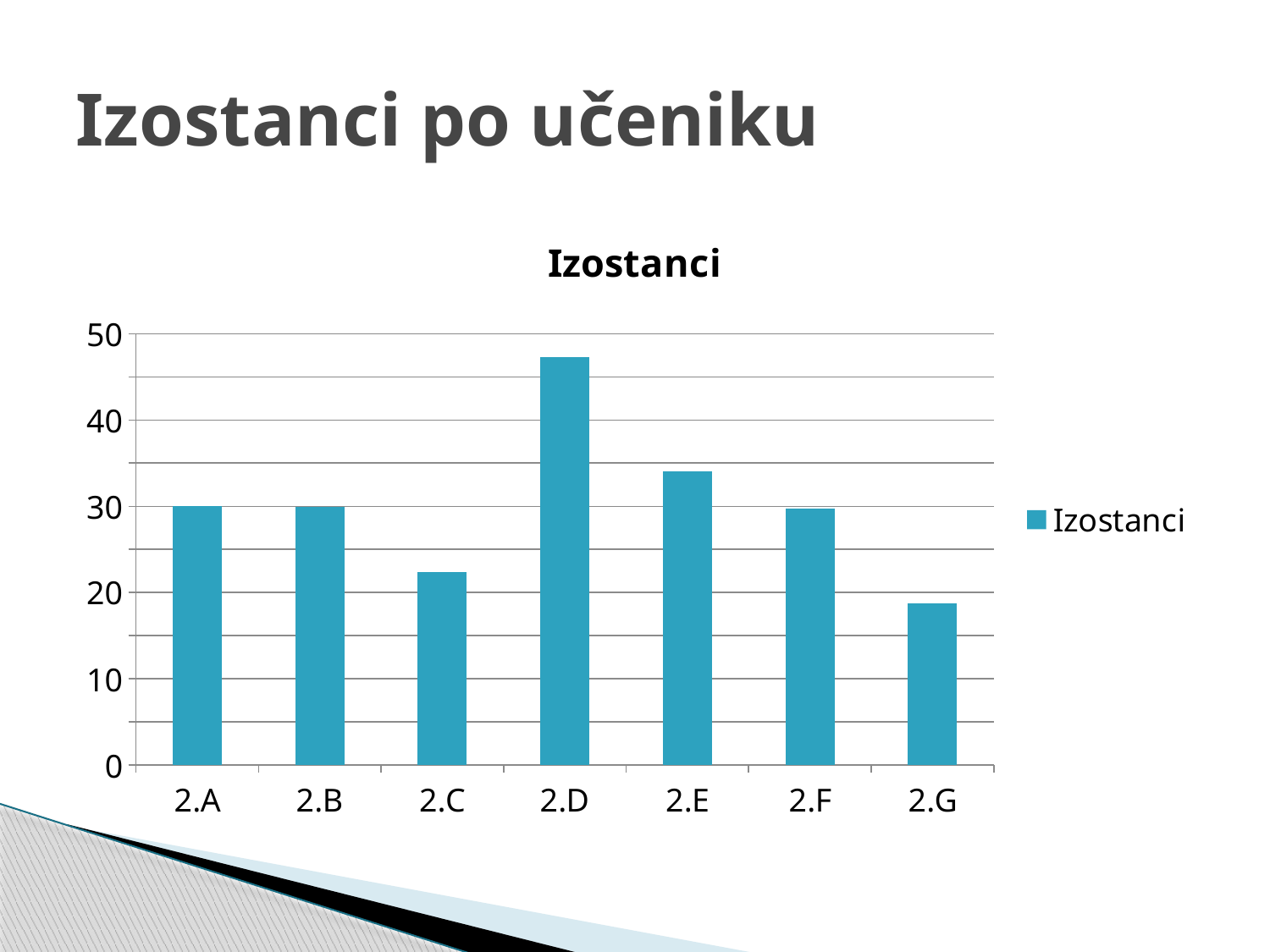
Which is larger, the value for 2.D or the value for 2.E? 2.D What is the title of the chart? Izostanci Is the value for 2.C greater or less than 30? less Is the value for 2.E greater or less than 30? greater How many series does the legend list? 1 Is the value for 2.D greater or less than 40? greater What kind of chart is shown on the slide? bar chart Which is larger, the value for 2.C or the value for 2.G? 2.C Which category has the lowest value? 2.G Which category has the highest value? 2.D How many categories are shown on the x axis of the chart? 7